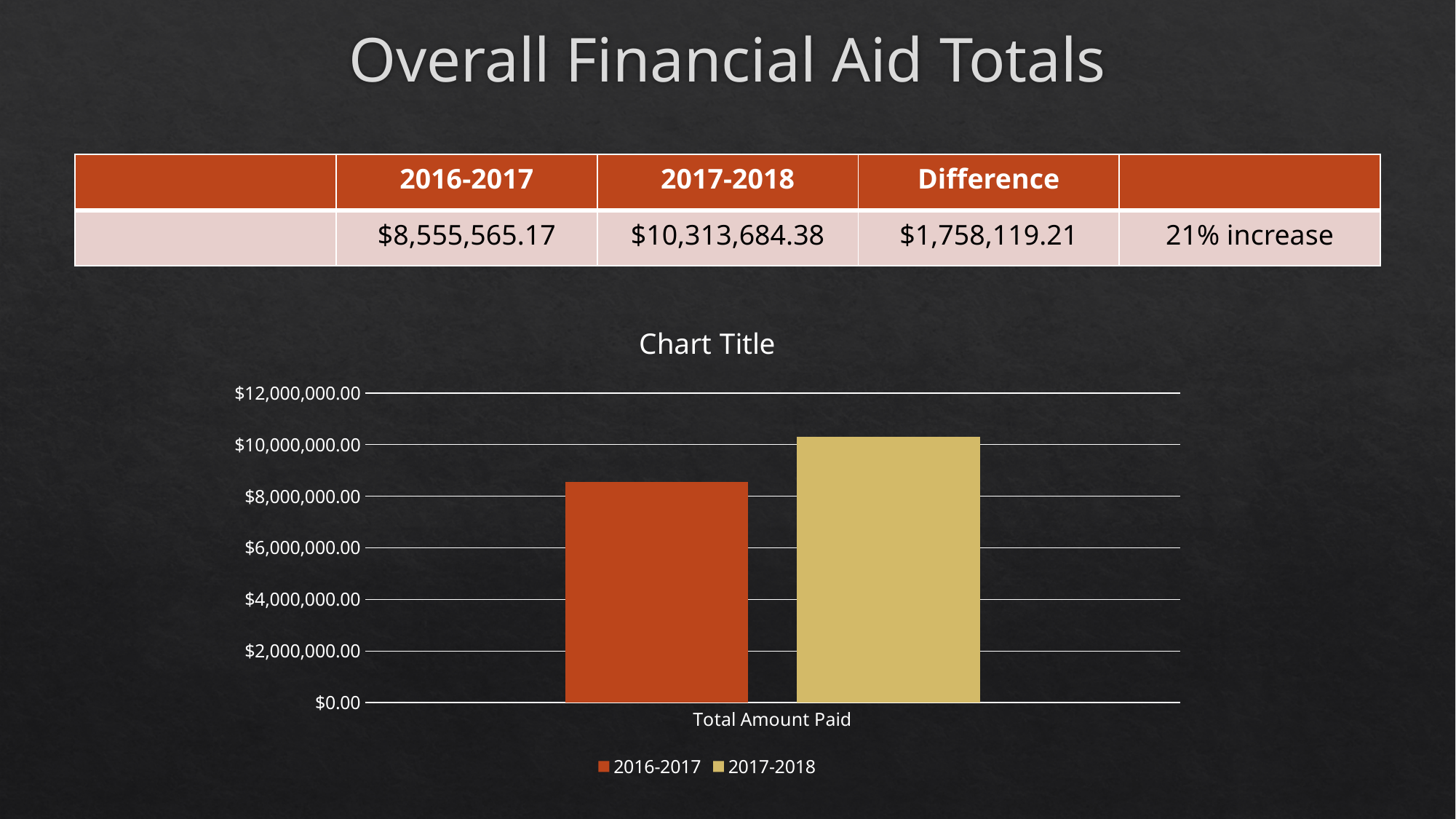
Is the value of the 2016-2017 bar greater or less than $10,000,000.00? less Is the value of the 2017-2018 bar greater or less than $10,000,000.00? greater What kind of chart is shown on the slide? bar chart Is the value of the 2016-2017 bar greater or less than $8,000,000.00? greater According to the table on the slide, what is the total amount for 2017-2018? $10,313,684.38 How many categories are shown on the x axis of the chart? 1 What is the title shown above the chart? Chart Title Which series has the lowest bar in the chart? 2016-2017 How many series does the chart legend list? 2 What is the category label on the x axis of the chart? Total Amount Paid Which series has the highest bar in the chart? 2017-2018 Which series has the taller bar in the chart, 2016-2017 or 2017-2018? 2017-2018